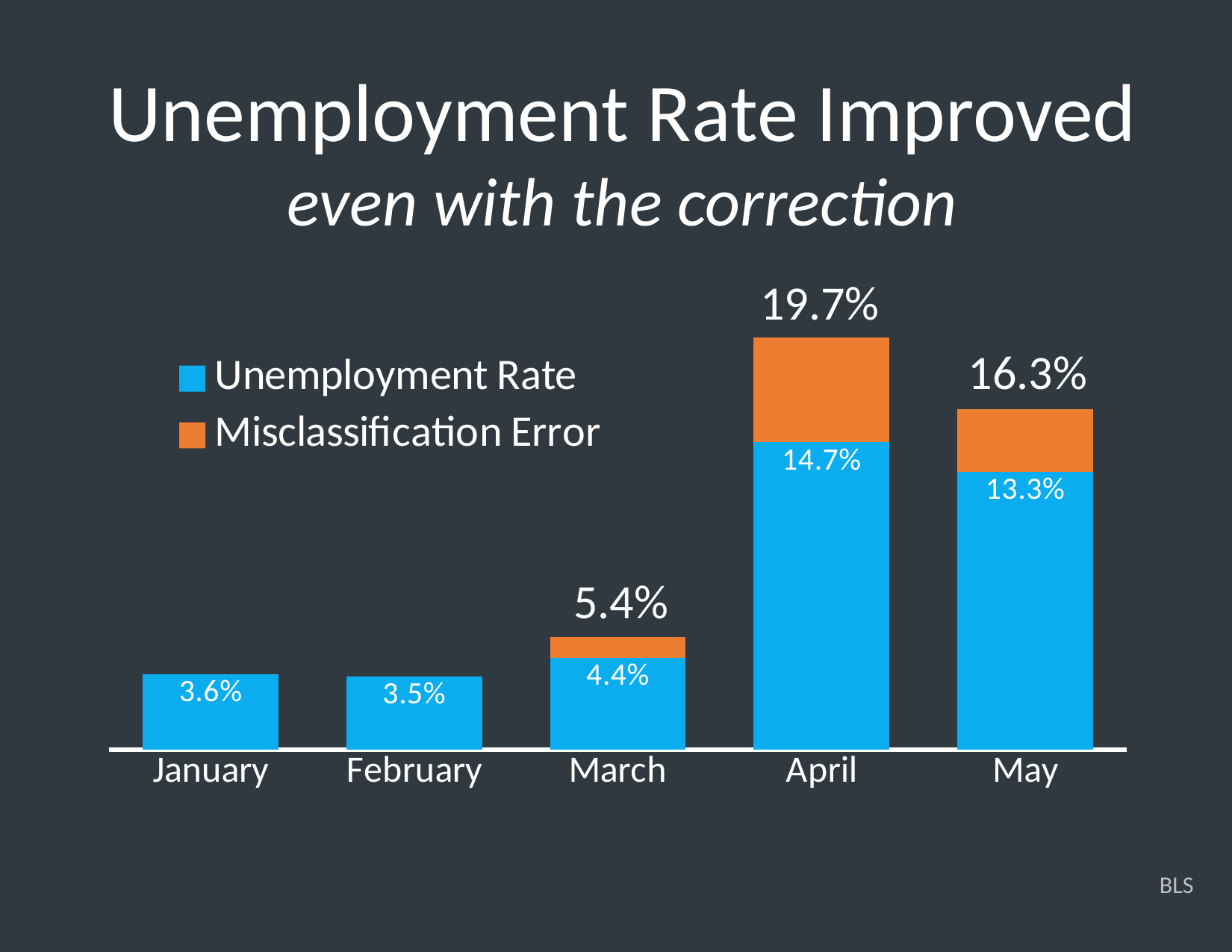
Which month has the lowest Unemployment Rate? February What is the difference between the total for April and the total for May? 3.4% What is the total height of the stacked bar for March? 5.4% Which month has the highest Unemployment Rate? April What is the Unemployment Rate for April? 14.7% What is the difference between the Unemployment Rate in April and in May? 1.4% What kind of chart is shown on the slide? Stacked bar chart Which is larger, the Unemployment Rate for March or for February? March What is the Unemployment Rate for January? 3.6% How many months are shown on the x axis? 5 How many series does the legend list? 2 What is the total height of the stacked bar for May? 16.3%